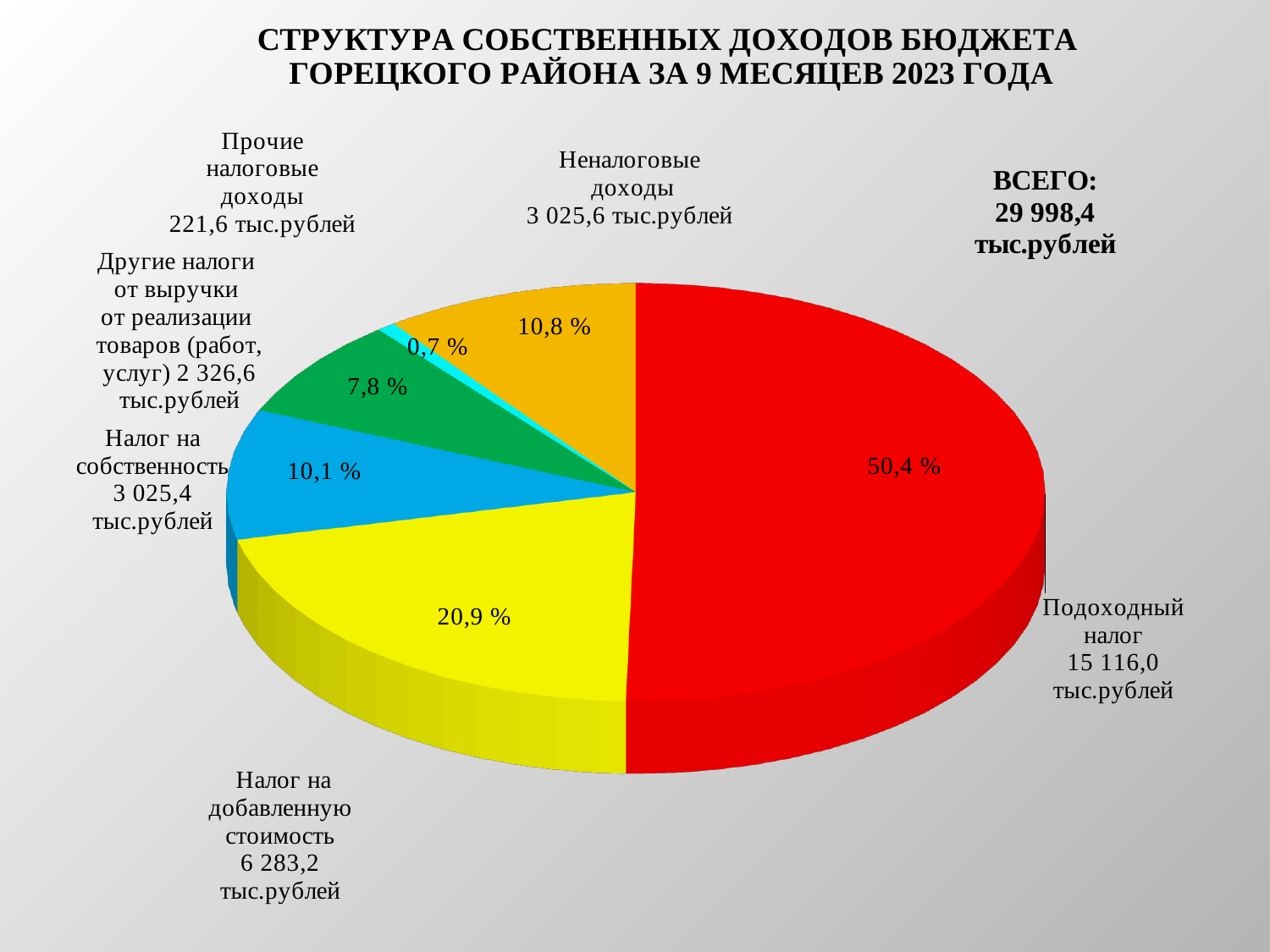
Which category has the smallest share of the pie? Прочие налоговые доходы Which is larger: the share for Неналоговые доходы or the share for Другие налоги от выручки от реализации товаров (работ, услуг)? Неналоговые доходы What is the value shown for Неналоговые доходы? 3 025,6 тыс.рублей What share of the pie does Подоходный налог account for? 50,4 % What colour is the slice for Подоходный налог? red What is the total (ВСЕГО) shown on the slide? 29 998,4 тыс.рублей What is the difference in percentage points between the share of Подоходный налог and the share of Налог на добавленную стоимость? 29,5 % How many slices does the pie chart have? 6 What is the value shown for Налог на добавленную стоимость? 6 283,2 тыс.рублей Which category has the largest share of the pie? Подоходный налог What percentage share is shown for Налог на собственность? 10,1 % What type of chart is shown on the slide? pie chart